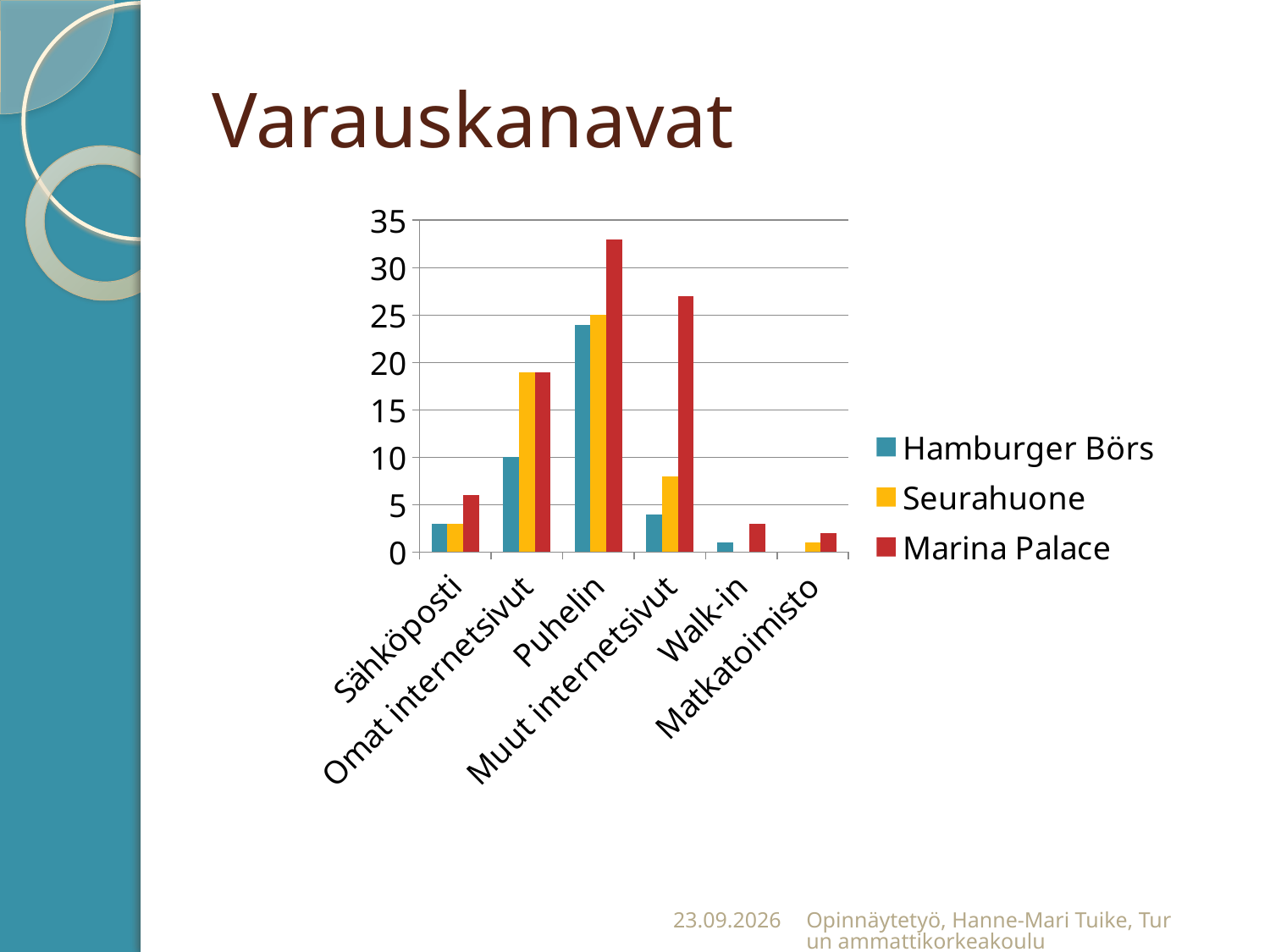
Is the value for Seurahuone in Muut internetsivut greater or less than 10? less Which is larger in Muut internetsivut: the value for Hamburger Börs or for Marina Palace? Marina Palace Which category has the highest value for Marina Palace? Puhelin How many categories are shown on the x axis? 6 How many series does the legend list? 3 Is the value for Marina Palace in Puhelin greater or less than 30? greater Is the value for Marina Palace in Muut internetsivut greater or less than 25? greater Which category has the highest value for Hamburger Börs? Puhelin Which series is shown in red in the legend? Marina Palace Which is larger in Omat internetsivut: the value for Hamburger Börs or for Seurahuone? Seurahuone What is the title of the slide containing the chart? Varauskanavat What kind of chart is shown on the slide? bar chart